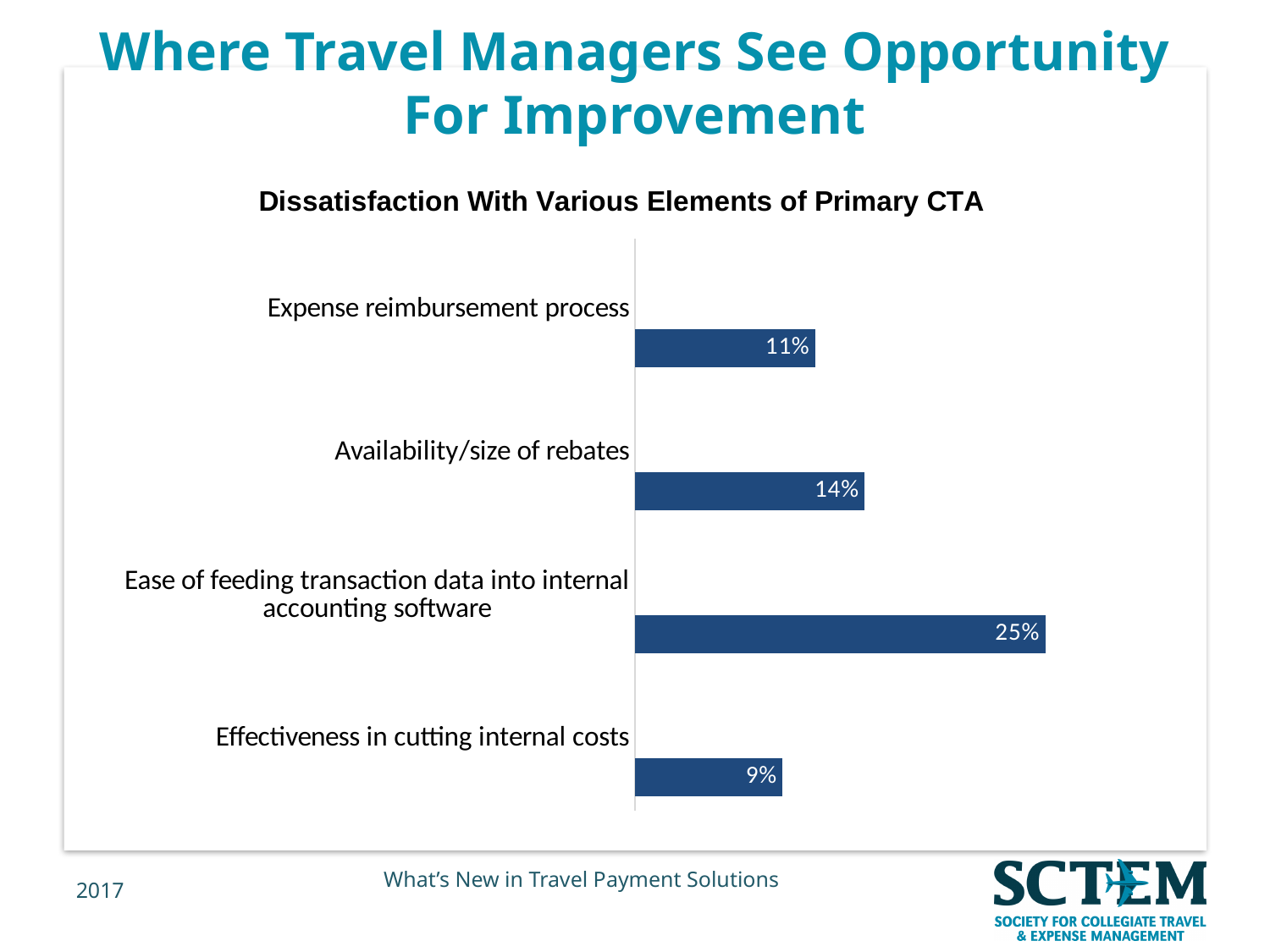
What kind of chart is shown on the slide? Bar chart What is the dissatisfaction value for Expense reimbursement process? 11% Which has a higher dissatisfaction value, Availability/size of rebates or Expense reimbursement process? Availability/size of rebates What is the title of the chart? Dissatisfaction With Various Elements of Primary CTA Which element has the lowest dissatisfaction value? Effectiveness in cutting internal costs How many elements are shown in the chart? 4 What is the difference between the dissatisfaction values for Ease of feeding transaction data into internal accounting software and Availability/size of rebates? 11% What is the dissatisfaction value for Availability/size of rebates? 14% What is the dissatisfaction value for Effectiveness in cutting internal costs? 9% Which element has the highest dissatisfaction value? Ease of feeding transaction data into internal accounting software What is the difference between the dissatisfaction values for Expense reimbursement process and Effectiveness in cutting internal costs? 2% What is the dissatisfaction value for Ease of feeding transaction data into internal accounting software? 25%